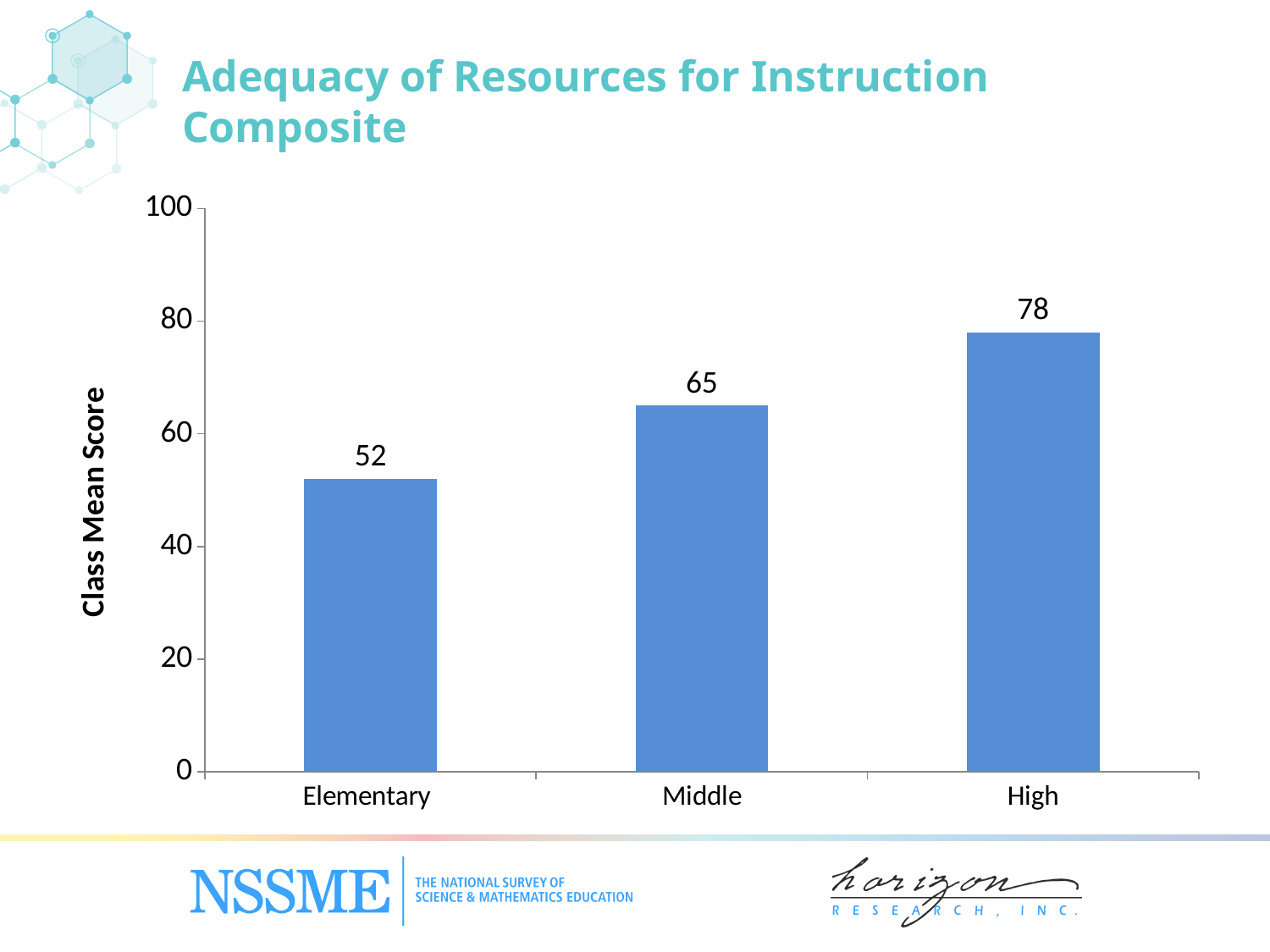
What is the class mean score for High? 78 What is the class mean score for Elementary? 52 What is the difference between the class mean scores for Middle and Elementary? 13 Do the class mean scores rise or fall from Elementary to High? Rise Is the value for Middle greater or less than 60? greater Which school level has the lowest class mean score? Elementary What kind of chart is shown on the slide? Bar chart What is the class mean score for Middle? 65 What is the difference between the class mean scores for High and Elementary? 26 How many school levels are shown on the chart? 3 Which has a larger class mean score, Middle or High? High Which school level has the highest class mean score? High